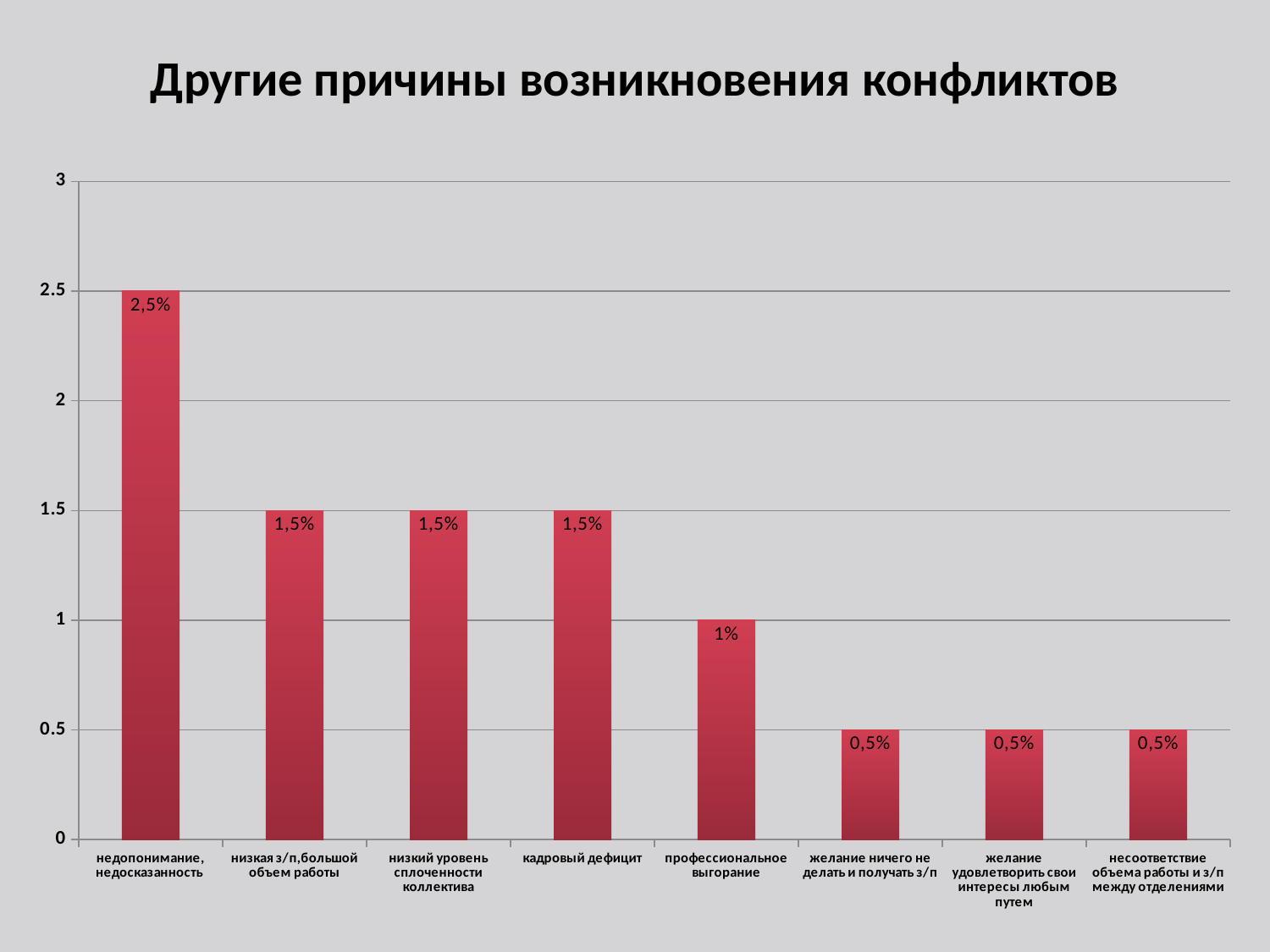
Which is larger: the value for «кадровый дефицит» or the value for «профессиональное выгорание»? кадровый дефицит What is the difference between the values for «недопонимание, недосказанность» and «профессиональное выгорание»? 1,5% What is the value for «профессиональное выгорание»? 1% What is the difference between the values for «низкая з/п, большой объем работы» and «несоответствие объема работы и з/п между отделениями»? 1% What is the value for «недопонимание, недосказанность»? 2,5% Is the value for «недопонимание, недосказанность» greater or less than 2? greater How many categories are shown on the chart? 8 Which category has the highest value? недопонимание, недосказанность What is the title of the chart? Другие причины возникновения конфликтов What is the value for «кадровый дефицит»? 1,5% What kind of chart is shown on the slide? bar chart What is the value for «желание ничего не делать и получать з/п»? 0,5%